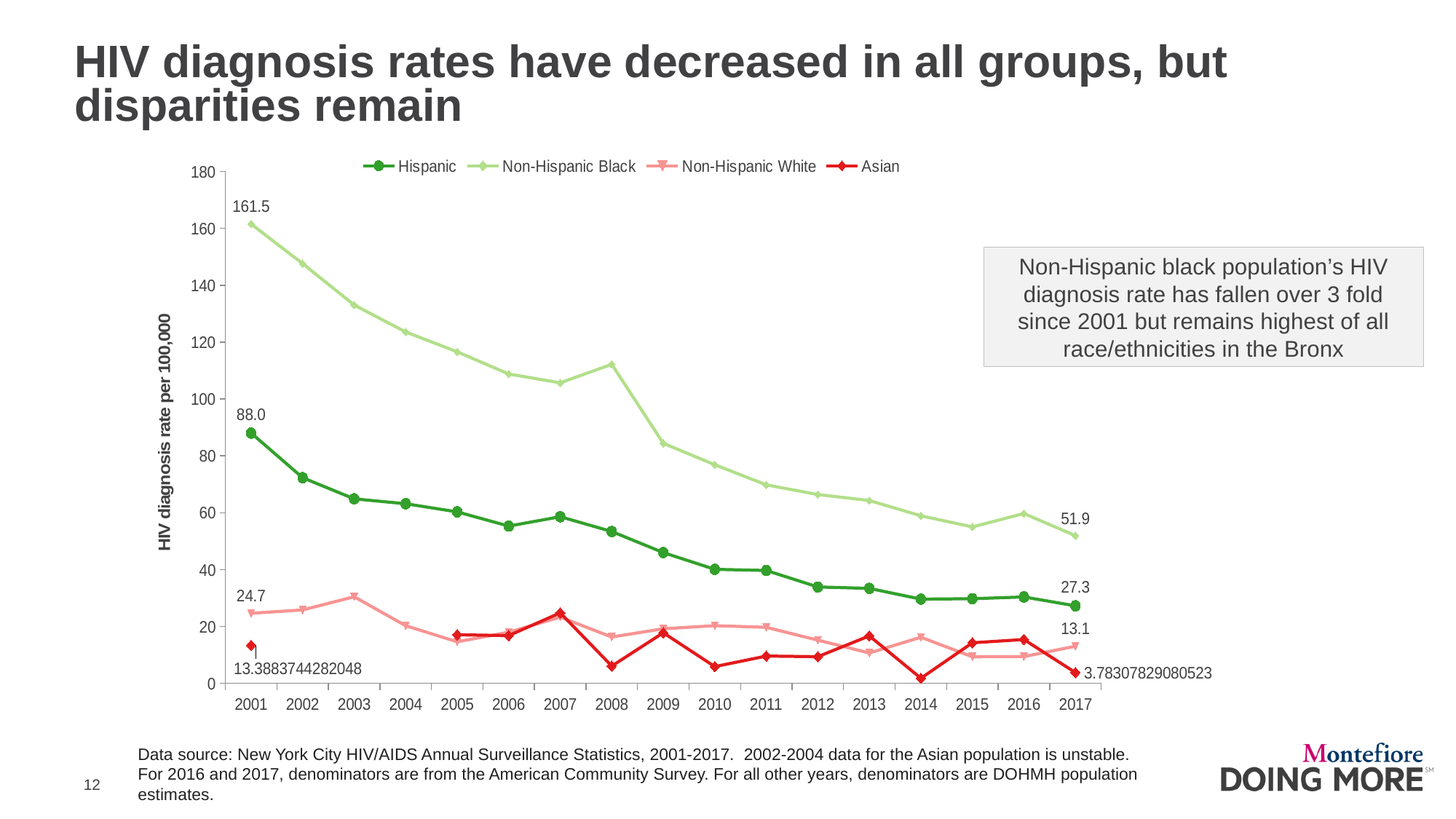
What was the HIV diagnosis rate for the Non-Hispanic White population in 2017? 13.1 What type of chart is shown on the slide? line chart What was the HIV diagnosis rate for the Hispanic population in 2017? 27.3 By how much did the Hispanic HIV diagnosis rate fall from 2001 to 2017? 60.7 What was the HIV diagnosis rate for the Non-Hispanic Black population in 2017? 51.9 What was the HIV diagnosis rate for the Hispanic population in 2001? 88.0 What was the HIV diagnosis rate for the Non-Hispanic Black population in 2001? 161.5 How many series does the legend list? 4 Which group had the highest HIV diagnosis rate in 2017? Non-Hispanic Black What was the HIV diagnosis rate for the Non-Hispanic White population in 2001? 24.7 How many years are shown on the x axis? 17 Is the Non-Hispanic Black HIV diagnosis rate in 2009 greater or less than 100? less